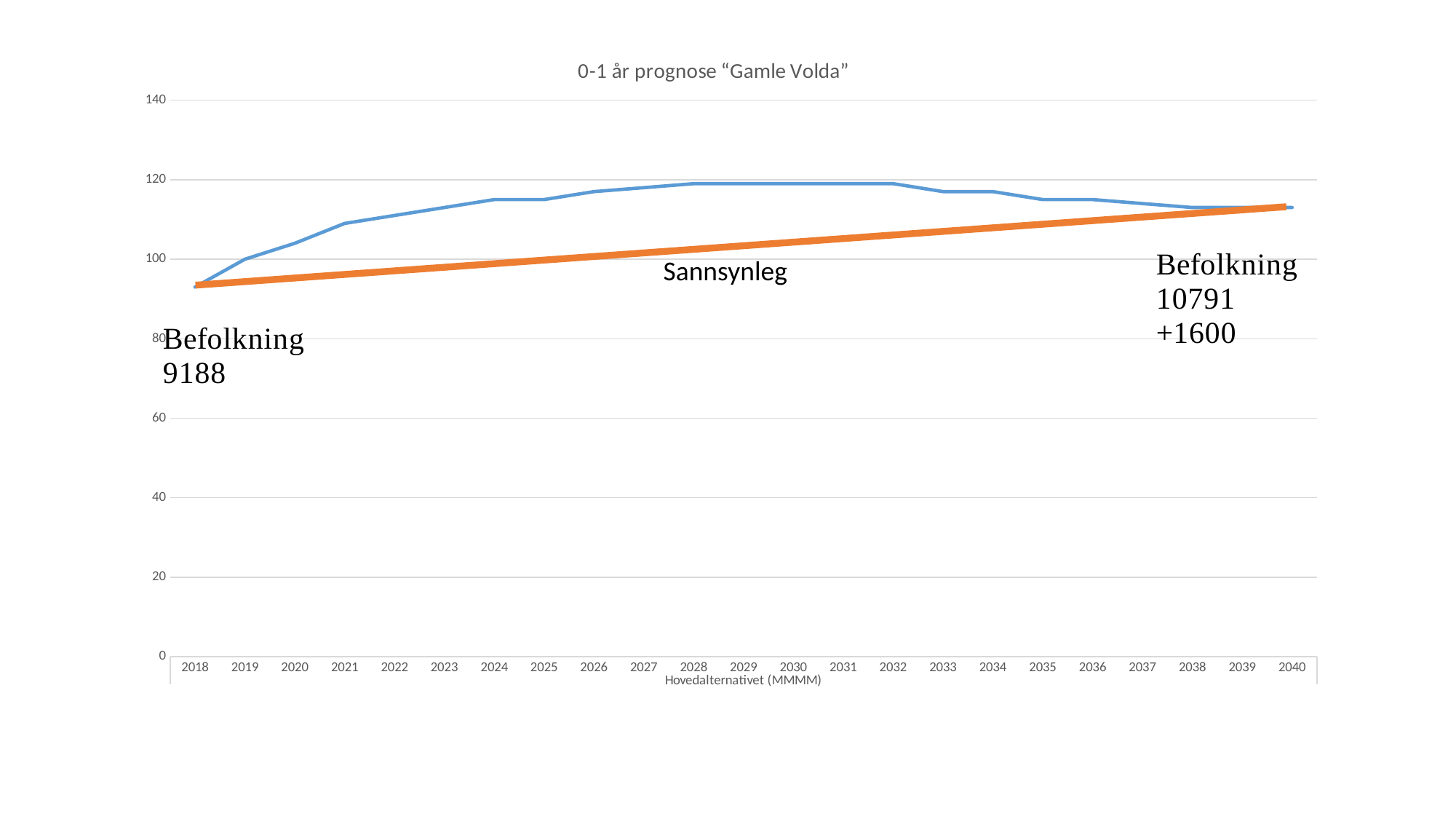
Is the value for 2021 greater or less than 100? greater Is the value for 2028 greater or less than 100? greater Is the value for 2040 greater or less than 100? greater How many years are shown on the x axis of the chart? 23 Does the blue line rise or fall between 2018 and 2028? rise Which year has the lowest value on the blue line? 2018 Which is larger, the value for 2018 or the value for 2028? 2028 What kind of chart is shown on the slide? line chart What is the title of the chart? 0-1 år prognose "Gamle Volda" What label is shown below the x axis of the chart? Hovedalternativet (MMMM)